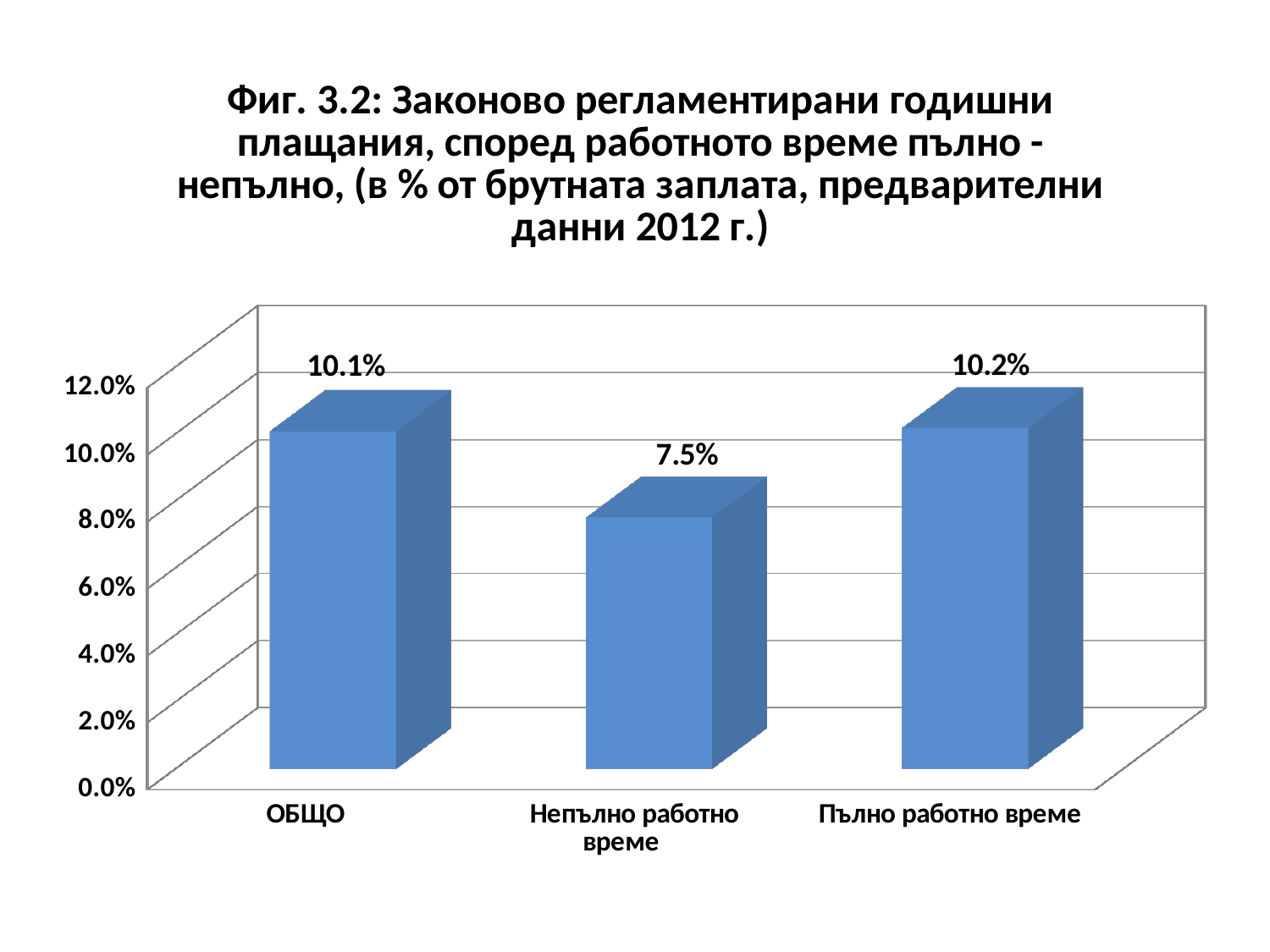
Which category has the lowest value? Непълно работно време What is the value for Непълно работно време? 7.5% What is the figure number given in the chart title? Фиг. 3.2 What is the difference between the values for ОБЩО and Непълно работно време? 2.6% How many categories are shown on the chart? 3 What is the difference between the values for Пълно работно време and Непълно работно време? 2.7% What is the value for Пълно работно време? 10.2% Which is larger, the value for ОБЩО or the value for Непълно работно време? ОБЩО What kind of chart is shown on the slide? bar chart Which category has the highest value? Пълно работно време Is the value for Непълно работно време greater or less than 8.0%? less What is the value for ОБЩО? 10.1%